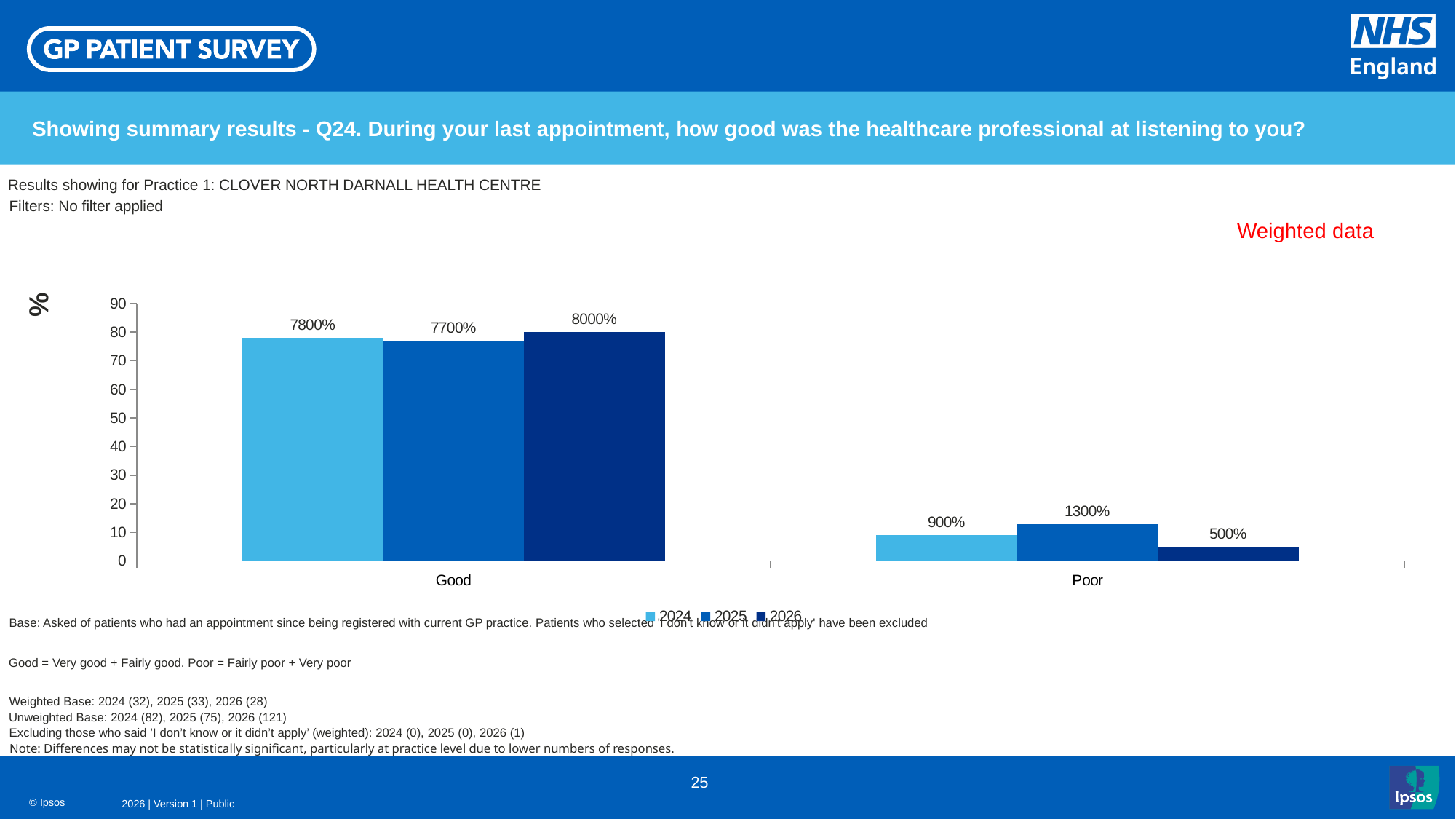
Which year has the highest bar in the Good category? 2026 What is the data label shown for the 2025 bar in the Poor category? 1300% How many series does the legend list? 3 How many categories are shown on the x axis? 2 Which year has the lowest bar in the Poor category? 2026 What is the data label shown for the 2024 bar in the Good category? 7800% What are the series names listed in the legend? 2024, 2025, 2026 What is the data label shown for the 2026 bar in the Good category? 8000% Which is larger in the Poor category, the 2024 bar or the 2025 bar? 2025 What is the data label shown for the 2026 bar in the Poor category? 500% Is the 2025 bar in the Good category above or below the 70 mark on the y axis? above What kind of chart is shown on the slide? bar chart